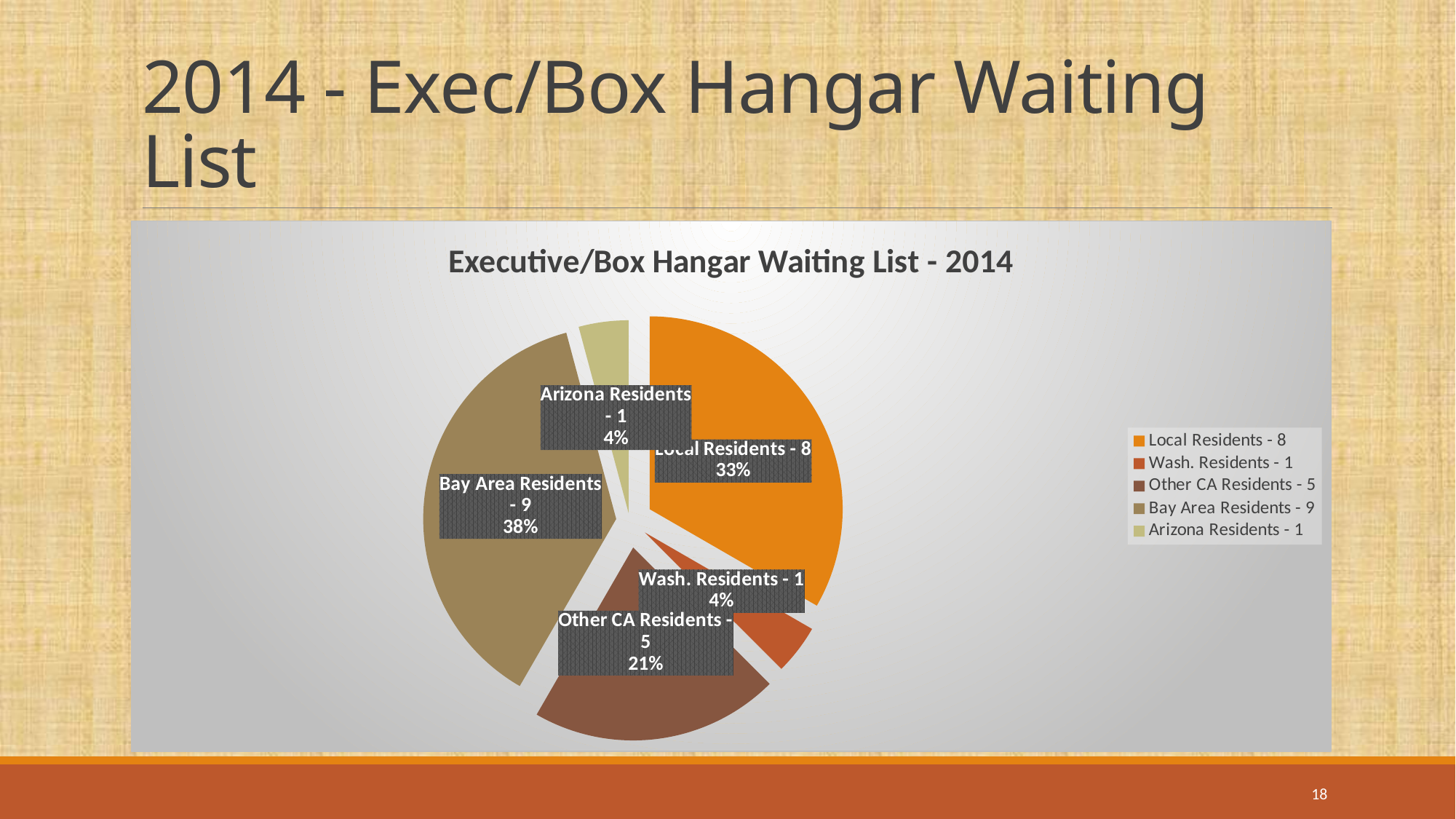
What percentage share of the pie do Other CA Residents have? 21% How many people are on the waiting list from Bay Area Residents? 9 How many categories does the pie chart show? 5 Which category has the largest slice of the pie? Bay Area Residents What is the difference in count between Bay Area Residents and Local Residents? 1 What is the total number of people across all categories on the waiting list? 24 How many people are on the waiting list from Other CA Residents? 5 What percentage share of the pie do Bay Area Residents have? 38% Which is larger, the count for Local Residents or the count for Other CA Residents? Local Residents What is the title of the chart? Executive/Box Hangar Waiting List - 2014 What type of chart is shown on the slide? Pie chart What percentage share of the pie do Local Residents have? 33%